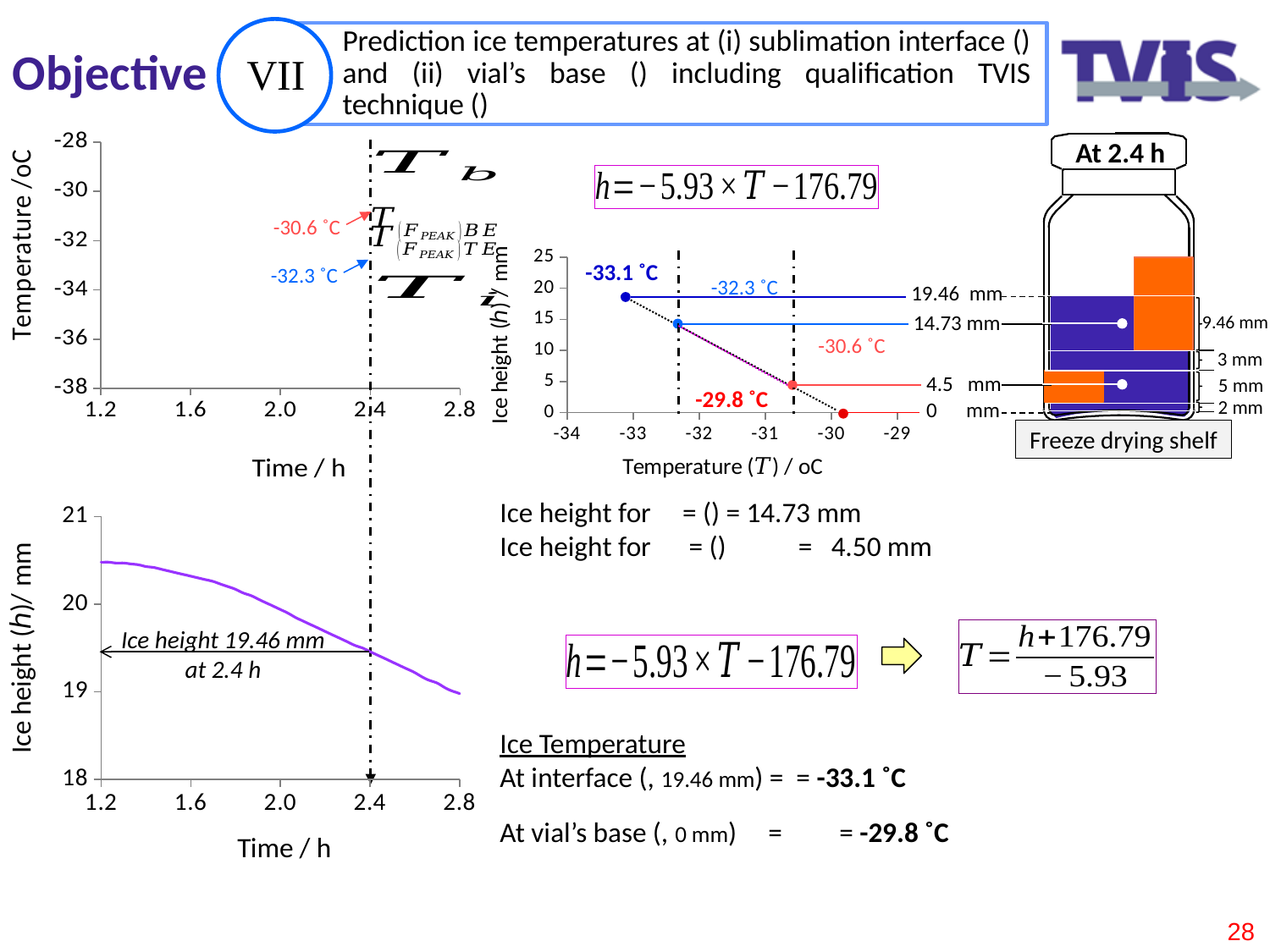
In the bottom-left chart of ice height against time, is the ice height at 1.2 h greater or less than 20 mm? greater In the middle chart of ice height against temperature, what is the ice height at -33.1 °C? 19.46 mm In the middle chart of ice height against temperature, how many data points are plotted? 4 In the middle chart of ice height against temperature, what is the difference in ice height between -33.1 °C and -32.3 °C? 4.73 mm In the middle chart of ice height against temperature, what is the ice height at -30.6 °C? 4.5 mm In the middle chart of ice height against temperature, does ice height rise or fall as temperature increases along the x axis? fall In the middle chart of ice height against temperature, what is the difference in ice height between -32.3 °C and -30.6 °C? 10.23 mm In the bottom-left chart of ice height against time, what is the ice height at 2.4 h? 19.46 mm In the middle chart of ice height against temperature, what is the ice height at -29.8 °C? 0 mm In the bottom-left chart of ice height against time, does the ice height rise or fall as time increases? fall What kind of chart is the middle chart of ice height against temperature? scatter chart In the middle chart of ice height against temperature, what is the ice height at -32.3 °C? 14.73 mm